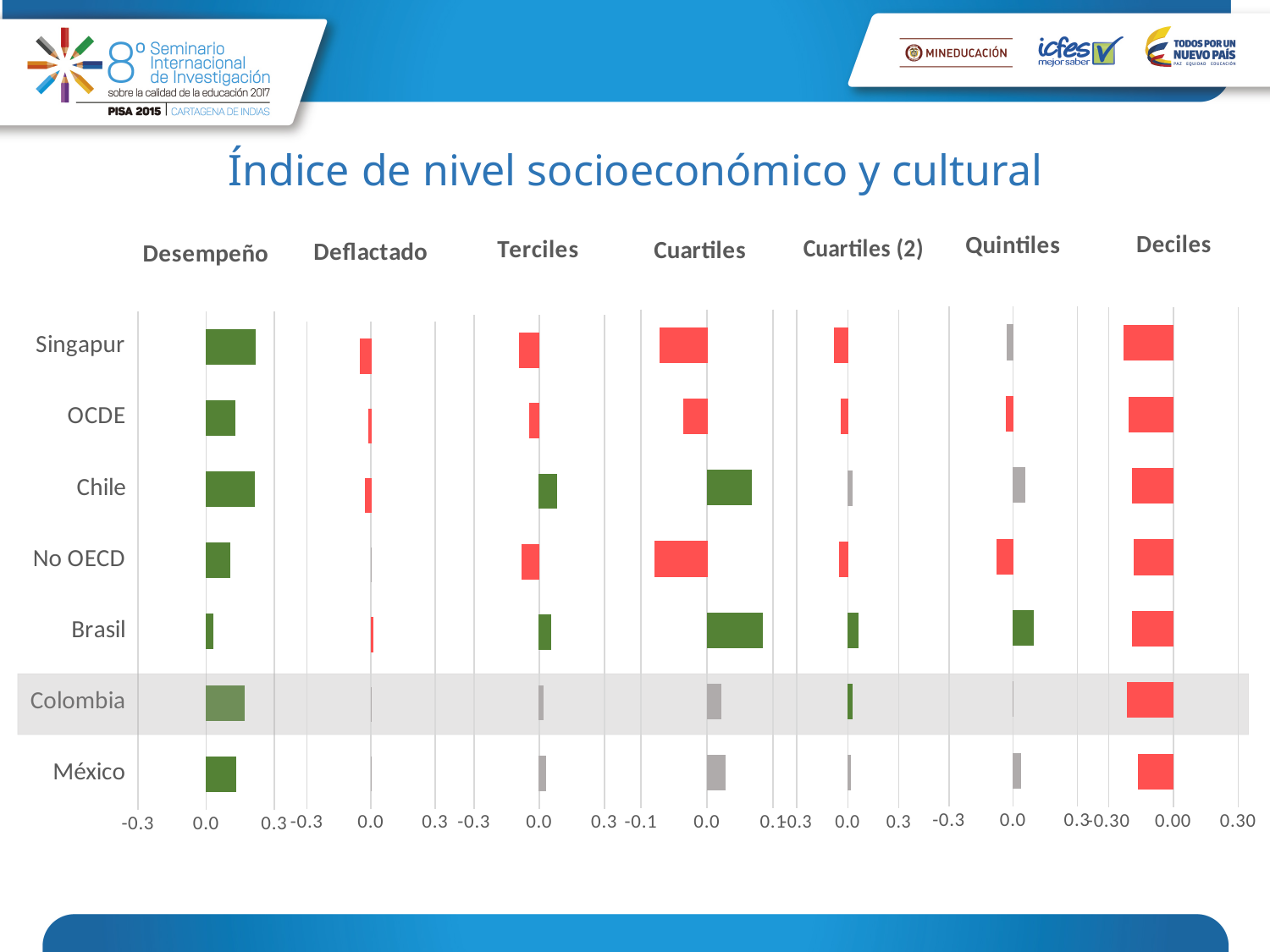
In the Desempeño chart, is the value for Chile greater or less than 0.0? greater In the Cuartiles chart, which category has the highest value? Brasil In the Desempeño chart, is the value for Singapur larger or smaller than the value for Brasil? larger What kind of chart is the Desempeño chart? bar chart In the Cuartiles chart, is the value for Brasil larger or smaller than the value for No OECD? larger In the Quintiles chart, which category has the highest value? Brasil In the Desempeño chart, which category has the lowest value? Brasil In the Cuartiles chart, is the value for No OECD greater or less than 0.0? less What is the title of the slide containing these charts? Índice de nivel socioeconómico y cultural How many countries or groups are listed on the vertical axis of the Desempeño chart? 7 In the Cuartiles chart, which category has the lowest value? No OECD In the Deciles chart, is the value for Singapur greater or less than 0.00? less